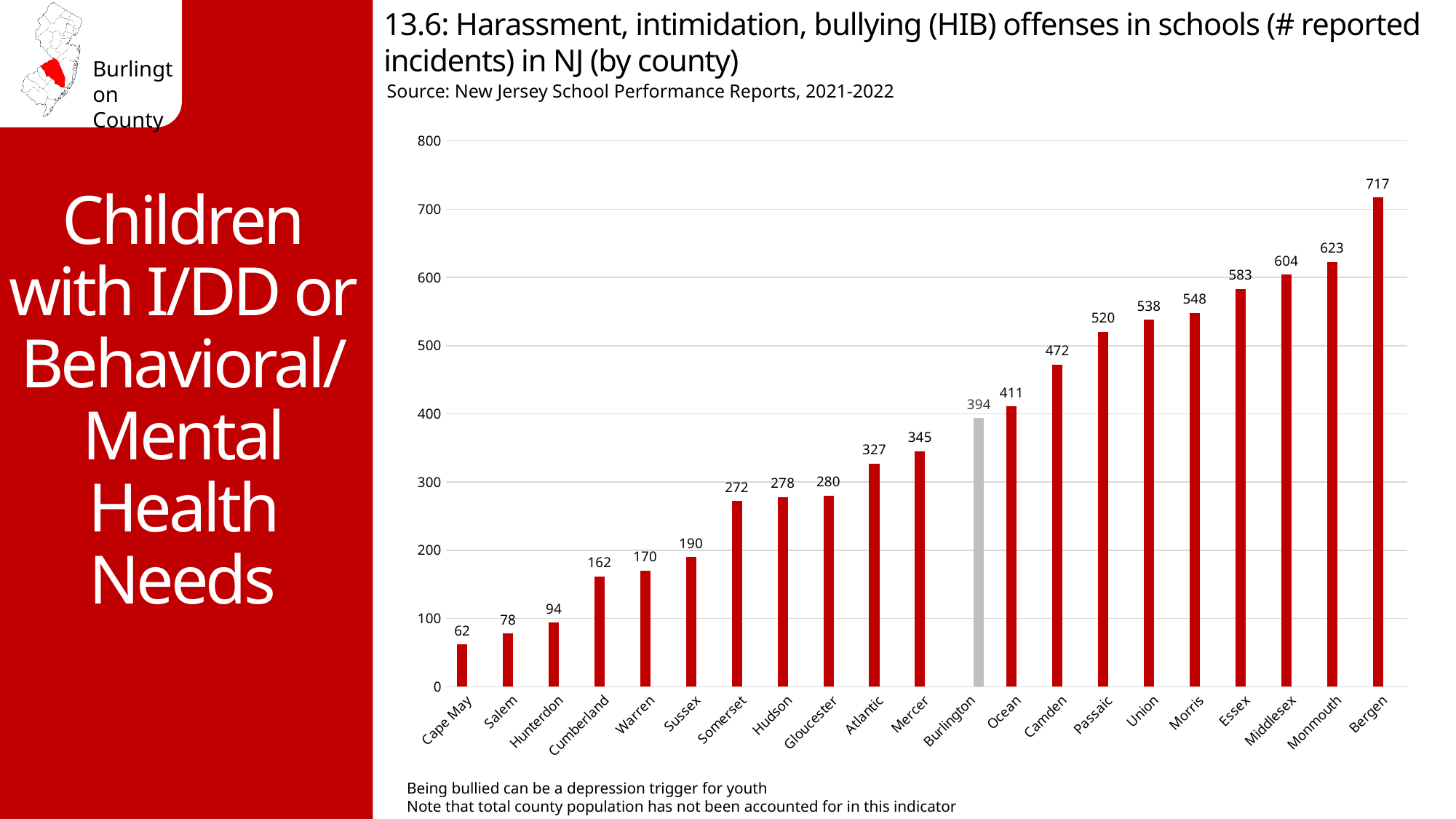
Do the values rise or fall moving from left to right along the x axis? Rise What is the number of reported HIB incidents for Burlington? 394 What kind of chart is shown on the slide? Bar chart What is the difference in reported HIB incidents between Ocean and Burlington? 17 Which county has the highest number of reported HIB incidents? Bergen Is the value for Passaic greater or less than 500? greater How many counties are shown on the chart? 21 Which county has more reported HIB incidents, Camden or Mercer? Camden Which county's bar is coloured grey instead of red? Burlington What is the difference in reported HIB incidents between Bergen and Cape May? 655 What is the number of reported HIB incidents for Hudson? 278 Which county has the lowest number of reported HIB incidents? Cape May